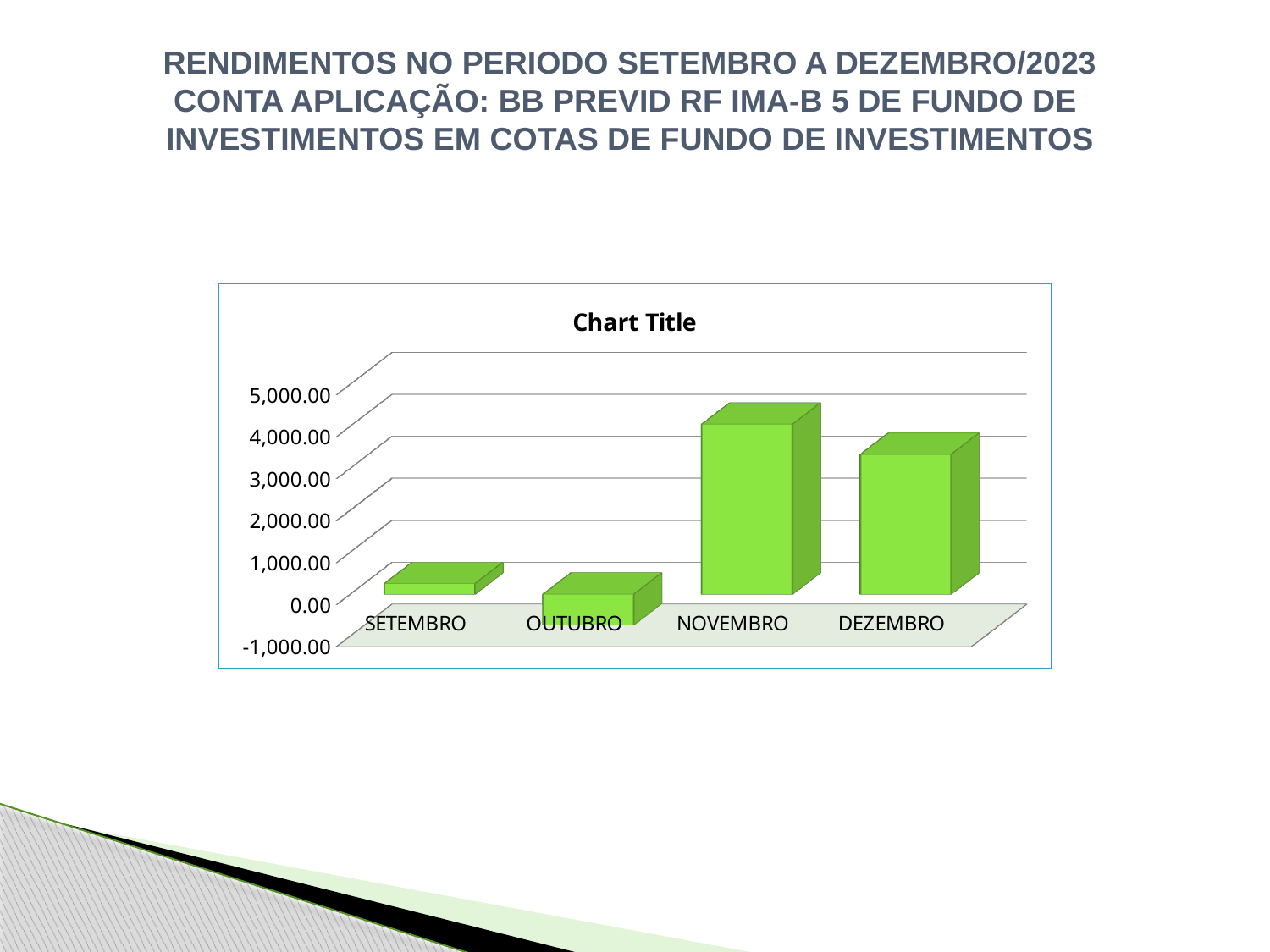
Which month has the highest value on the chart? NOVEMBRO Is the value for NOVEMBRO greater or less than 3,000.00? greater What is the lowest value shown on the vertical axis of the chart? -1,000.00 Is the value for OUTUBRO greater or less than 1,000.00? less Which is larger, the value for NOVEMBRO or the value for DEZEMBRO? NOVEMBRO Is the value for DEZEMBRO greater or less than 2,000.00? greater What is the title printed inside the chart area? Chart Title What kind of chart is shown on the slide? bar chart Which is larger, the value for SETEMBRO or the value for OUTUBRO? SETEMBRO How many categories (months) are plotted on the chart? 4 Which month has the lowest value on the chart? OUTUBRO